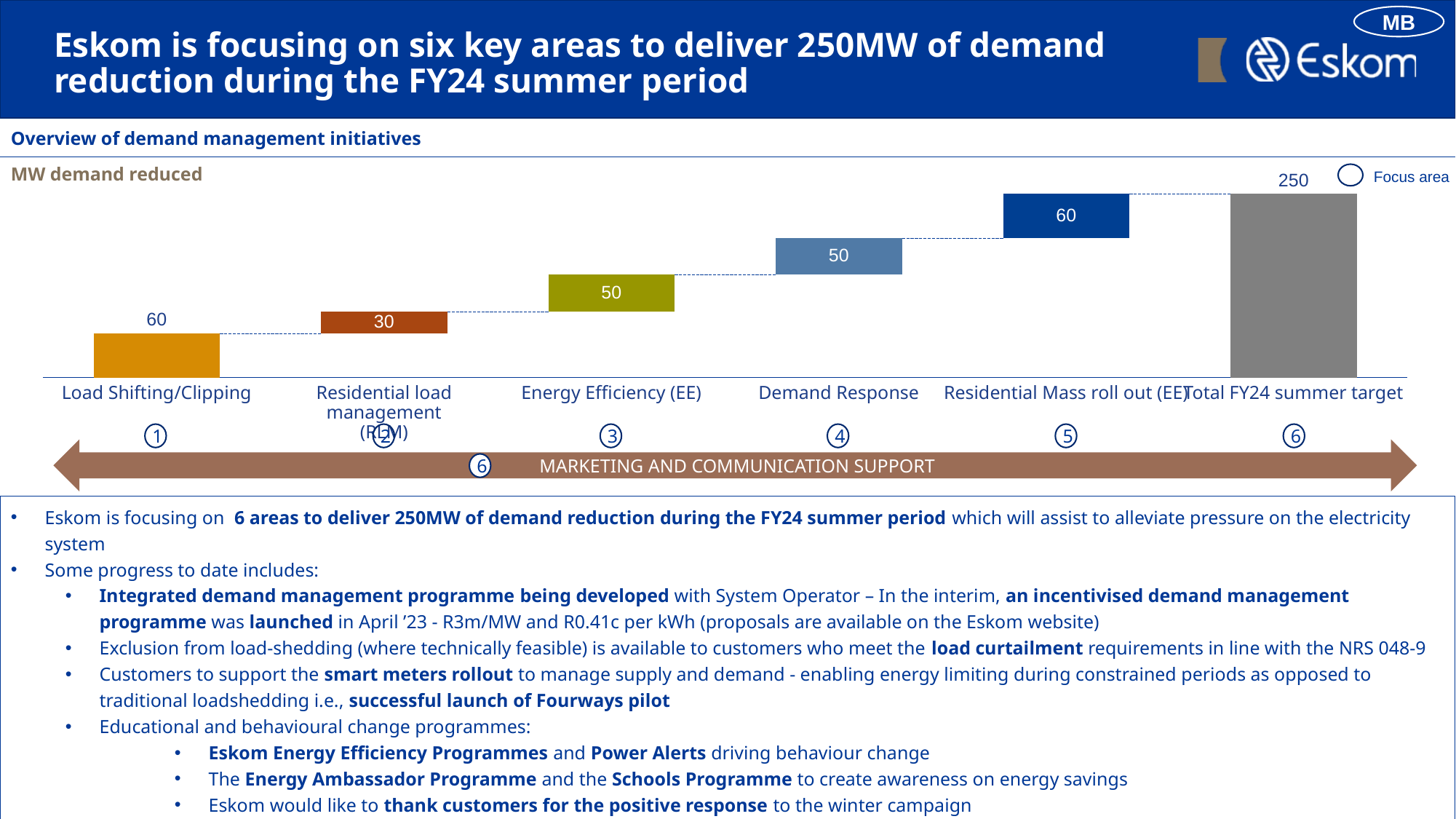
What is the Total FY24 summer target shown in the chart? 250 What is the value shown for Demand Response? 50 What is the value shown for Residential load management (RLM)? 30 Which is larger, the value for Energy Efficiency (EE) or the value for Residential Mass roll out (EE)? Residential Mass roll out (EE) What is the MW demand reduced value for Load Shifting/Clipping? 60 Which initiative has the lowest MW demand reduced value? Residential load management (RLM) What is the axis label shown above the chart? MW demand reduced What text is written on the brown arrow beneath the chart? MARKETING AND COMMUNICATION SUPPORT What is the difference between the Load Shifting/Clipping value and the Residential load management (RLM) value? 30 What kind of chart is shown on the slide? Bar chart (waterfall) What is the sum of the five initiative values (Load Shifting/Clipping, RLM, Energy Efficiency, Demand Response, Residential Mass roll out)? 250 How many categories are shown along the x axis of the chart? 6